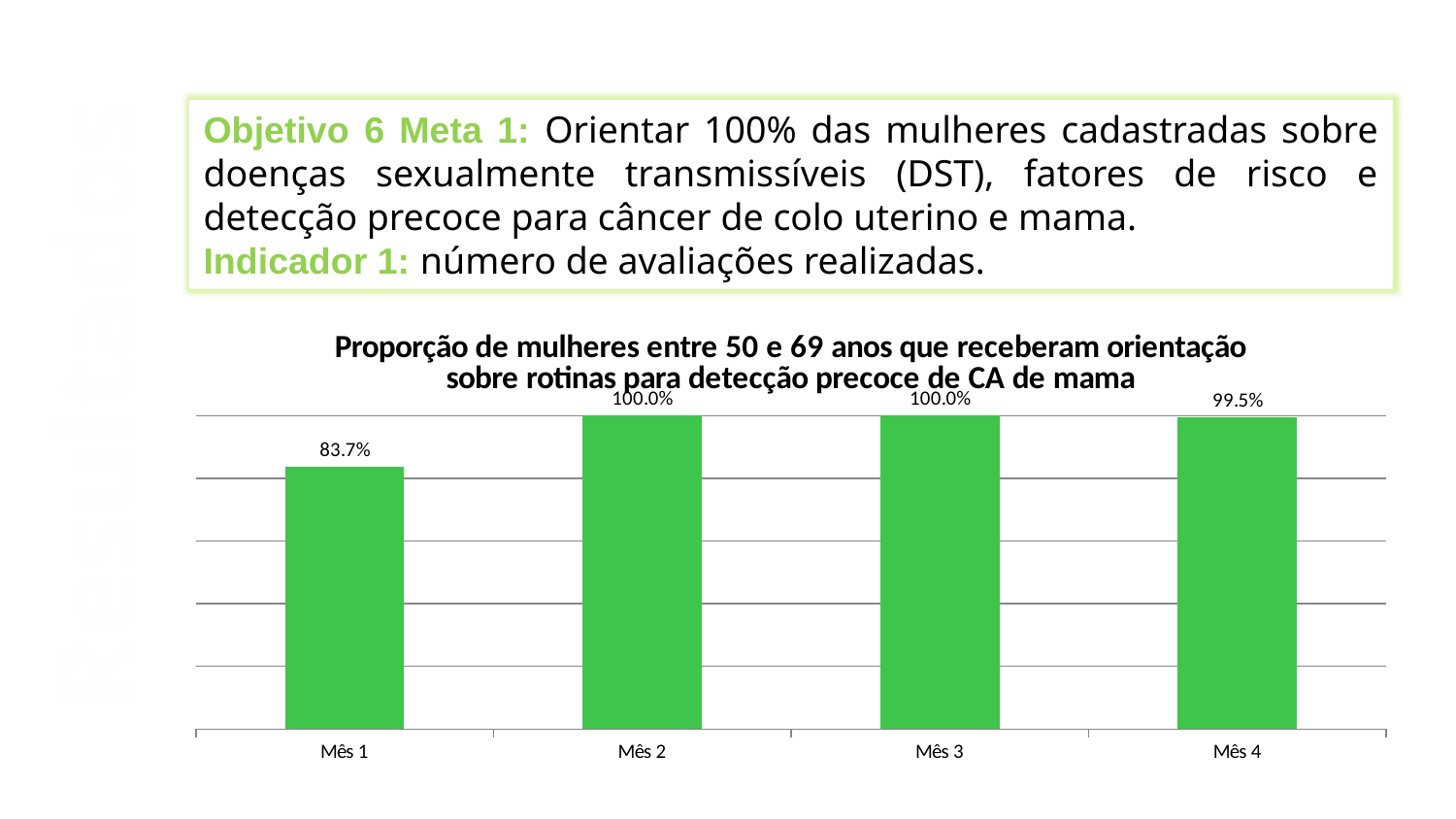
Does the value rise or fall from Mês 1 to Mês 2? rise How many months are shown on the x axis? 4 What is the highest value shown in the chart? 100.0% What is the value for Mês 1? 83.7% Which is larger, the value for Mês 1 or the value for Mês 4? Mês 4 What is the value for Mês 4? 99.5% What is the value for Mês 2? 100.0% Which month has the lowest value? Mês 1 What is the difference between the values for Mês 2 and Mês 1? 16.3% What is the difference between the values for Mês 3 and Mês 4? 0.5% What colour are the bars in the chart? green What kind of chart is shown on the slide? bar chart